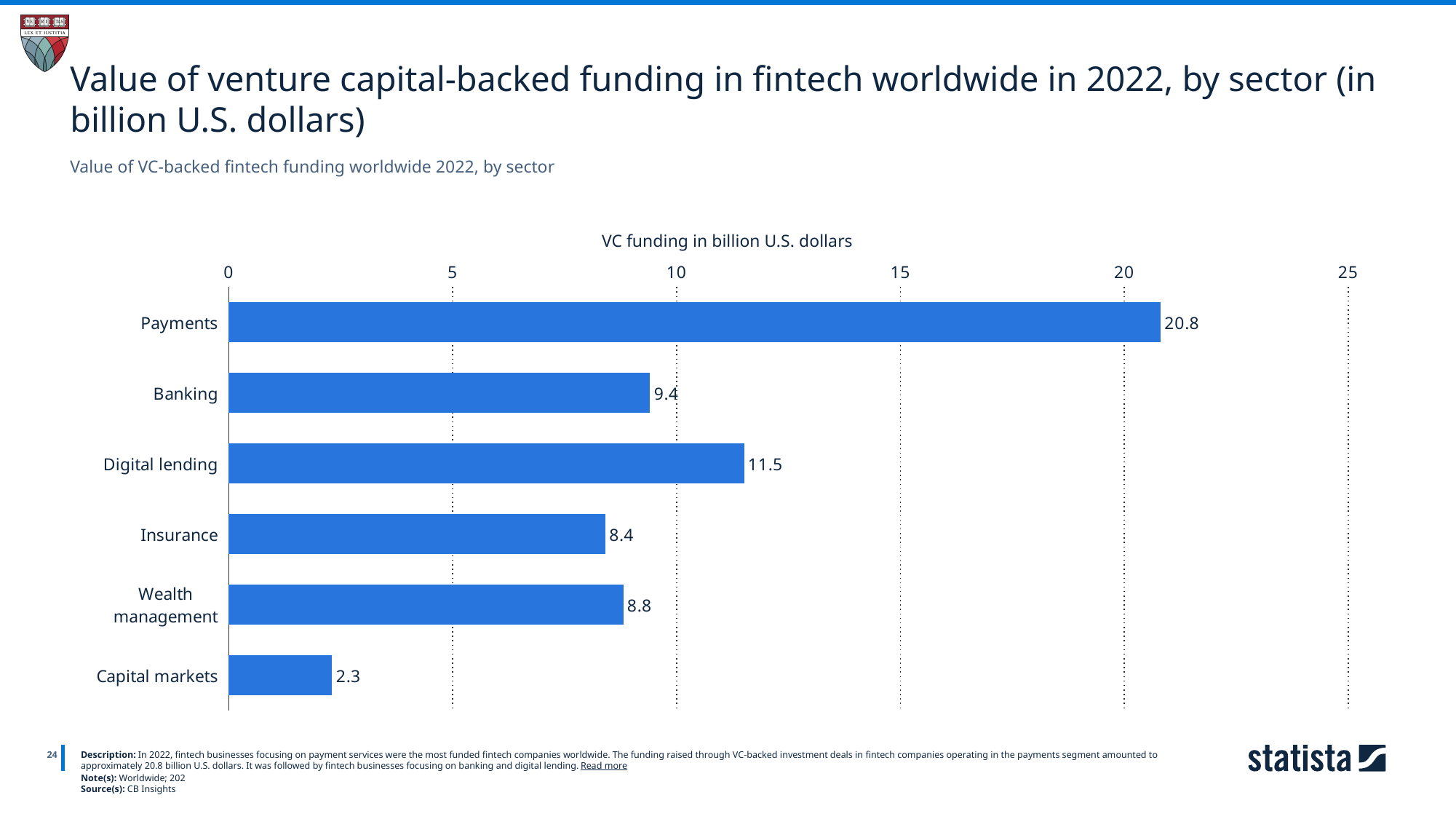
What is the VC funding value for Payments? 20.8 What kind of chart is shown on the slide? Bar chart What is the difference between the VC funding values for Digital lending and Insurance? 3.1 What is the axis title shown above the chart? VC funding in billion U.S. dollars What is the VC funding value for Digital lending? 11.5 How many sectors are shown in the chart? 6 What is the difference between the VC funding values for Payments and Banking? 11.4 Is the value for Insurance greater or less than 10? less Which sector has the highest VC funding value? Payments Which sector has the lowest VC funding value? Capital markets What is the VC funding value for Wealth management? 8.8 Which has a larger VC funding value, Banking or Digital lending? Digital lending